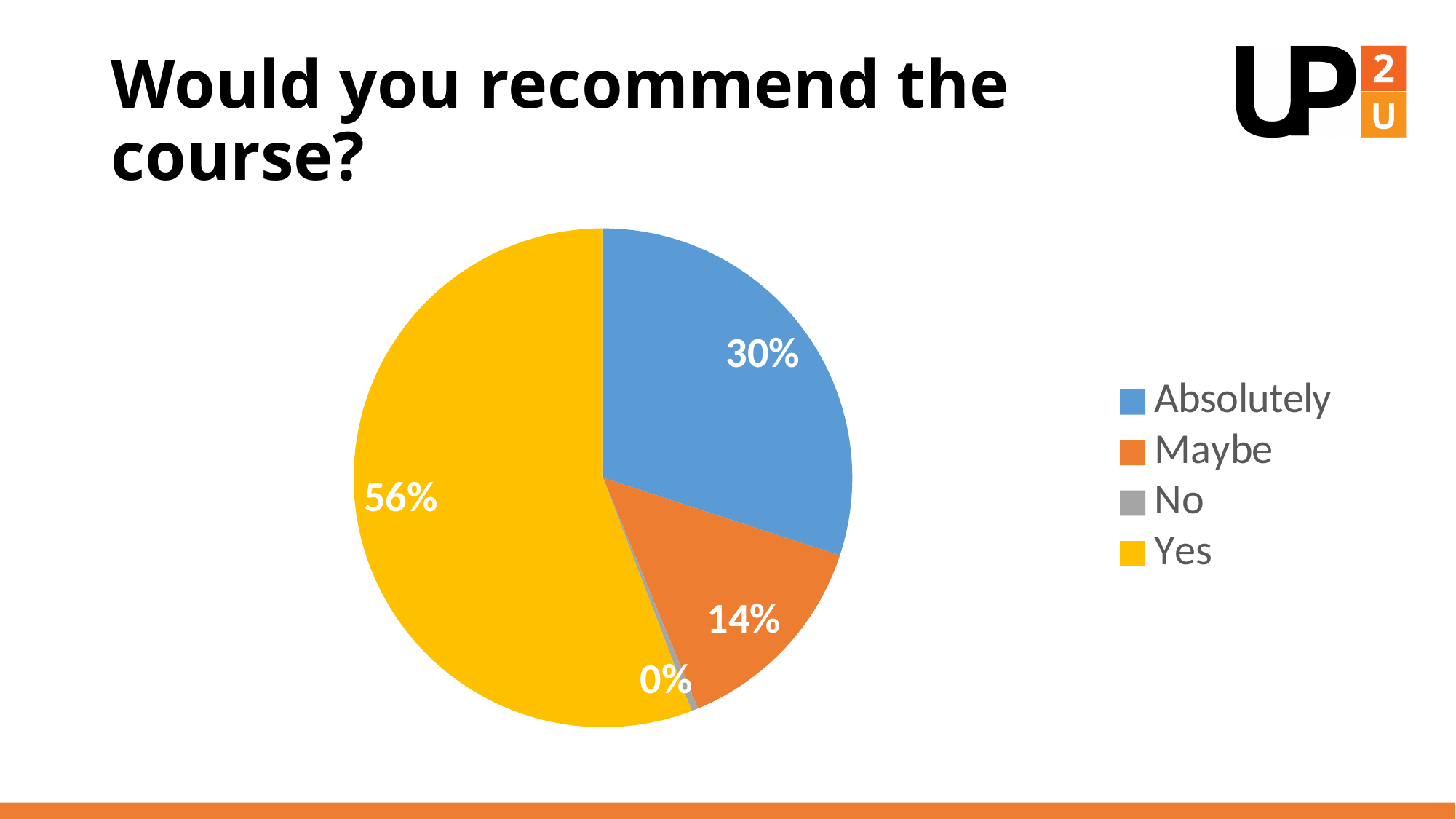
What kind of chart is shown on the slide? pie chart Which response has the smallest share of the pie? No What is the difference in percentage points between "Yes" and "Absolutely"? 26 Which is larger, the share for "Absolutely" or the share for "Maybe"? Absolutely What percentage of respondents answered "Maybe"? 14% What percentage of respondents answered "Yes"? 56% How many categories does the legend list? 4 What colour is the "Yes" slice? yellow What percentage of respondents answered "Absolutely"? 30% What is the title of the chart? Would you recommend the course? What percentage of respondents answered "No"? 0% Which response has the largest share of the pie? Yes